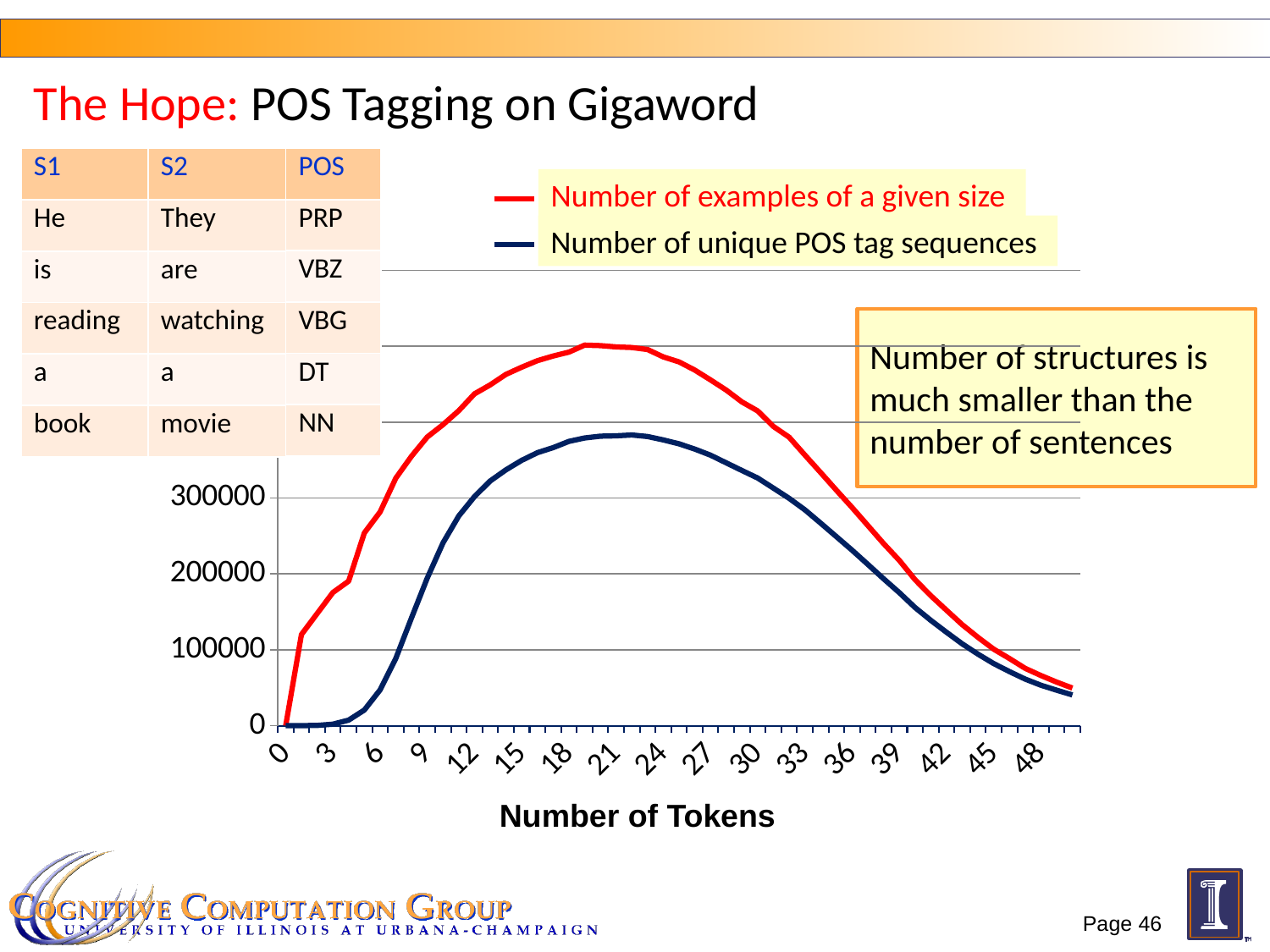
At 21 tokens, which series has the larger value? Number of examples of a given size Is the value of Number of examples of a given size at 48 tokens greater or less than 100000? less How many series does the legend list? 2 Is the value of Number of examples of a given size at 9 tokens greater or less than 300000? greater What kind of chart is shown on the slide? line chart Do the values of Number of examples of a given size rise or fall between 24 and 48 tokens? fall Which series is drawn in red? Number of examples of a given size How many tick labels are shown on the x axis? 17 What is the label of the x axis? Number of Tokens Which series reaches the higher peak, Number of examples of a given size or Number of unique POS tag sequences? Number of examples of a given size Is the value of Number of examples of a given size at 3 tokens greater or less than 100000? greater